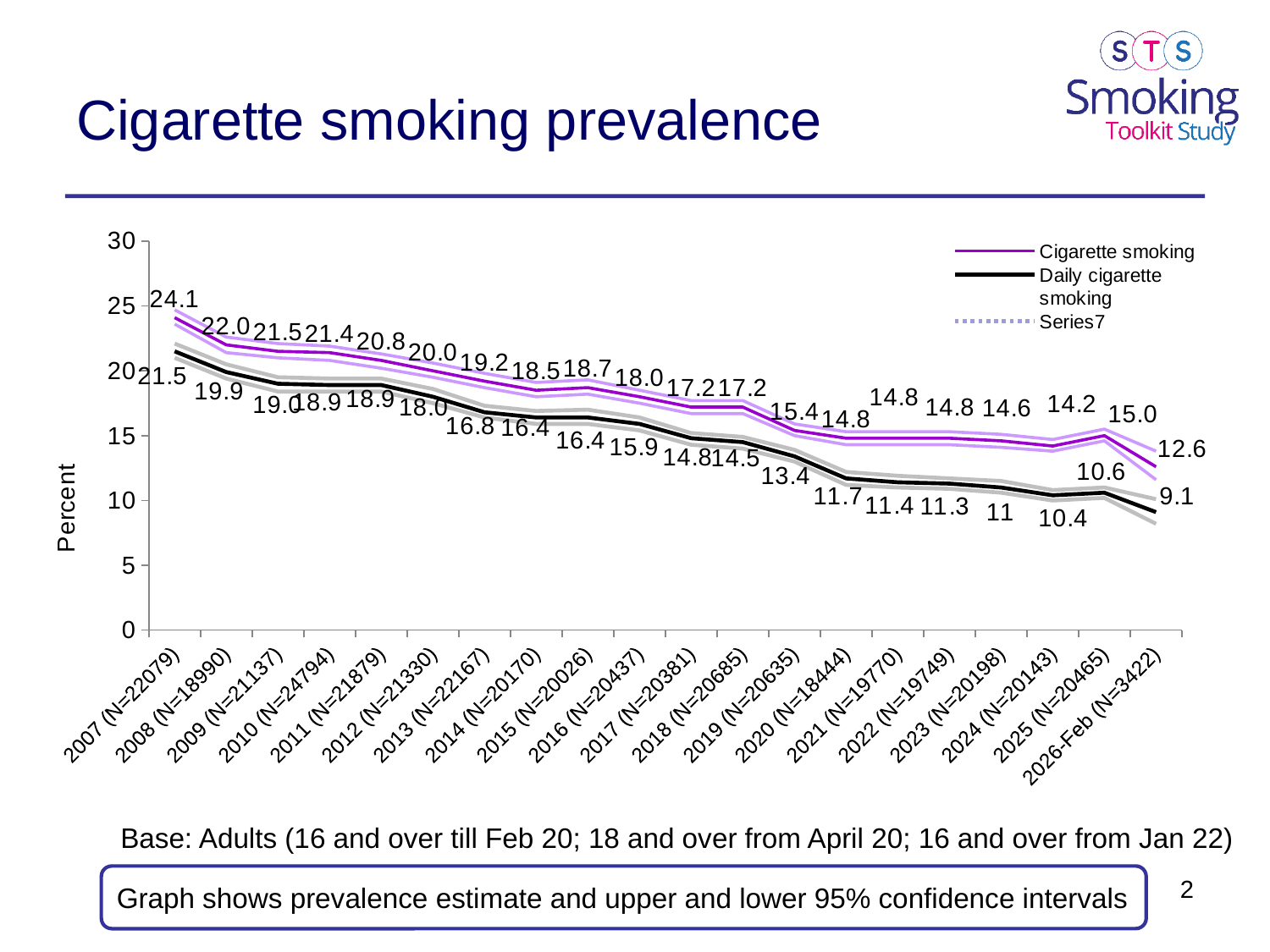
Which category has the lowest Daily cigarette smoking value? 2026-Feb (N=3422) Which category has the highest Cigarette smoking value? 2007 (N=22079) How many categories are shown on the x axis? 20 How many series does the legend list? 3 What is the Daily cigarette smoking value for 2026-Feb (N=3422)? 9.1 What kind of chart is shown on the slide? Line chart For 2019 (N=20635), which is larger: Cigarette smoking or Daily cigarette smoking? Cigarette smoking Do the Daily cigarette smoking values generally rise or fall from 2007 to 2026-Feb? Fall What is the Cigarette smoking value for 2019 (N=20635)? 15.4 What is the difference between the Cigarette smoking and Daily cigarette smoking values for 2025 (N=20465)? 4.4 What is the Cigarette smoking value for 2007 (N=22079)? 24.1 What is the difference between the Cigarette smoking values for 2007 (N=22079) and 2026-Feb (N=3422)? 11.5